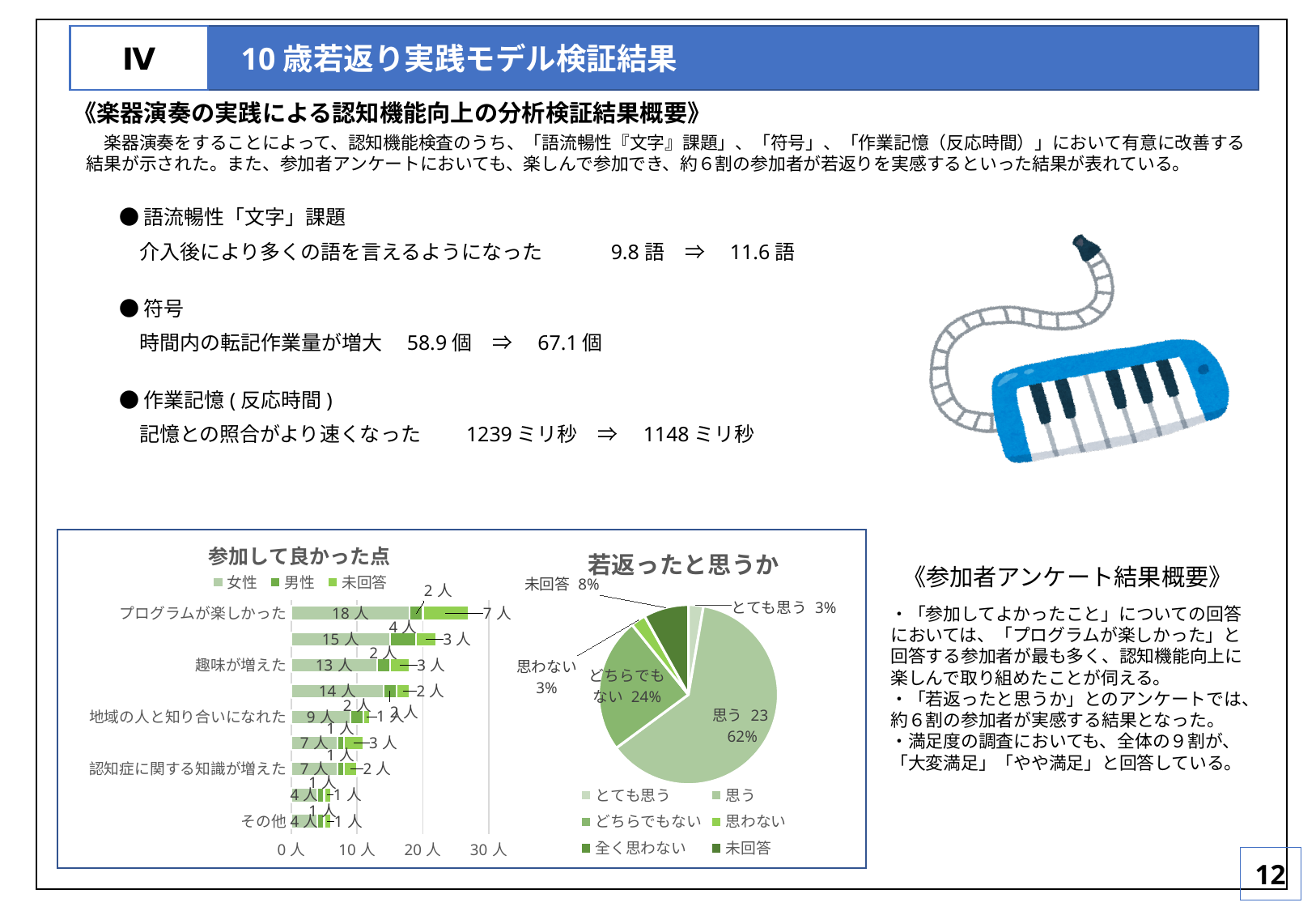
In the chart 参加して良かった点, what is the total of the stacked bar for プログラムが楽しかった? 27 人 In the chart 参加して良かった点, what is the difference between the 女性 values for プログラムが楽しかった and 趣味が増えた? 5 人 In the chart 参加して良かった点, what is the 未回答 value for プログラムが楽しかった? 7 人 What kind of chart is 参加して良かった点? Bar chart In the chart 参加して良かった点, what is the 女性 value for プログラムが楽しかった? 18 人 In the chart 参加して良かった点, which has the larger 女性 value, 認知症に関する知識が増えた or その他? 認知症に関する知識が増えた In the pie chart 若返ったと思うか, what share of responses is 思う? 62% In the pie chart 若返ったと思うか, what share of responses is どちらでもない? 24% In the pie chart 若返ったと思うか, which response has the largest slice? 思う In the pie chart 若返ったと思うか, what share of responses is 未回答? 8% How many entries does the legend of the pie chart 若返ったと思うか list? 6 How many series does the legend of the chart 参加して良かった点 list? 3